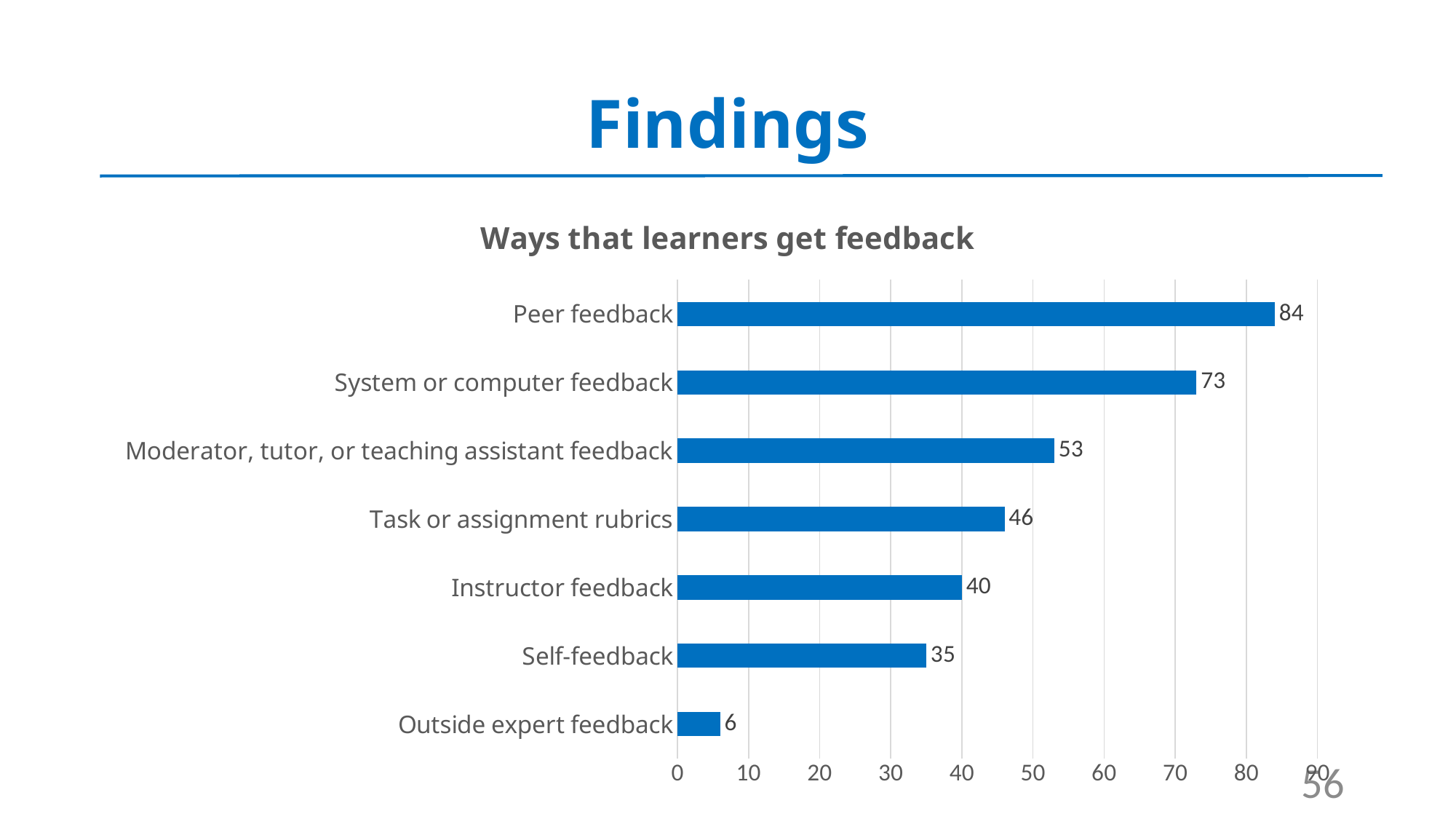
Which category has the lowest value? Outside expert feedback What is the value for Moderator, tutor, or teaching assistant feedback? 53 What is the value for Self-feedback? 35 What is the value for System or computer feedback? 73 Is the value for Instructor feedback greater or less than 50? less How many categories are shown in the chart? 7 What is the value for Peer feedback? 84 What is the title of the chart? Ways that learners get feedback What kind of chart is shown on the slide? bar chart Which category has the highest value? Peer feedback Which is larger, the value for Task or assignment rubrics or the value for Instructor feedback? Task or assignment rubrics What is the difference between the values for Peer feedback and System or computer feedback? 11